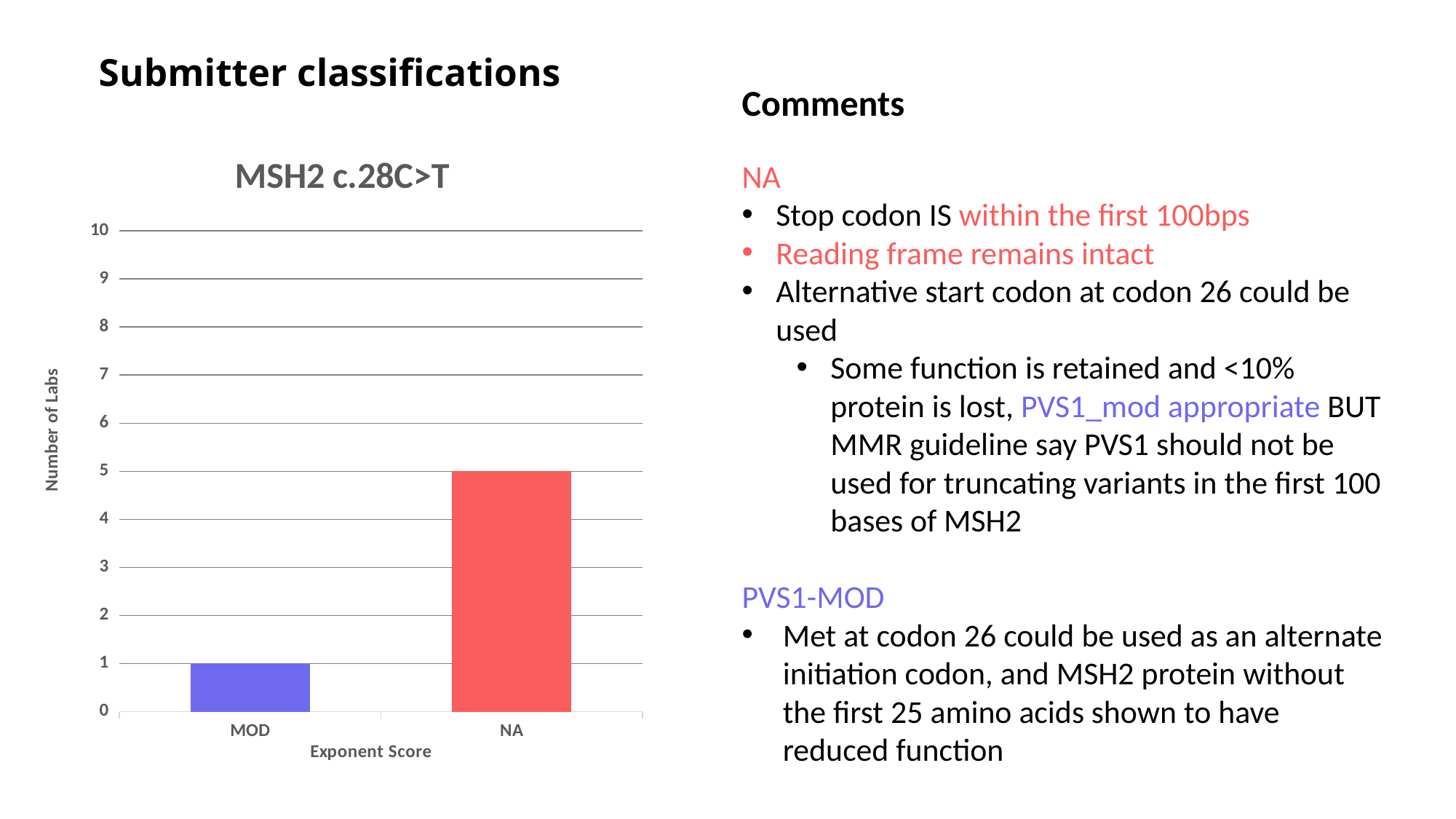
What is the title of the chart? MSH2 c.28C>T Which has more labs, MOD or NA? NA Is the value for NA greater or less than 3? greater What is the maximum value shown on the y axis of the chart? 10 What is the label of the y axis of the chart? Number of Labs What is the number of labs for the NA category? 5 What is the difference in number of labs between NA and MOD? 4 What kind of chart is shown on the slide? Bar chart Which category has the lowest number of labs? MOD What is the number of labs for the MOD category? 1 How many categories are shown on the x axis of the chart? 2 Which category has the highest number of labs? NA